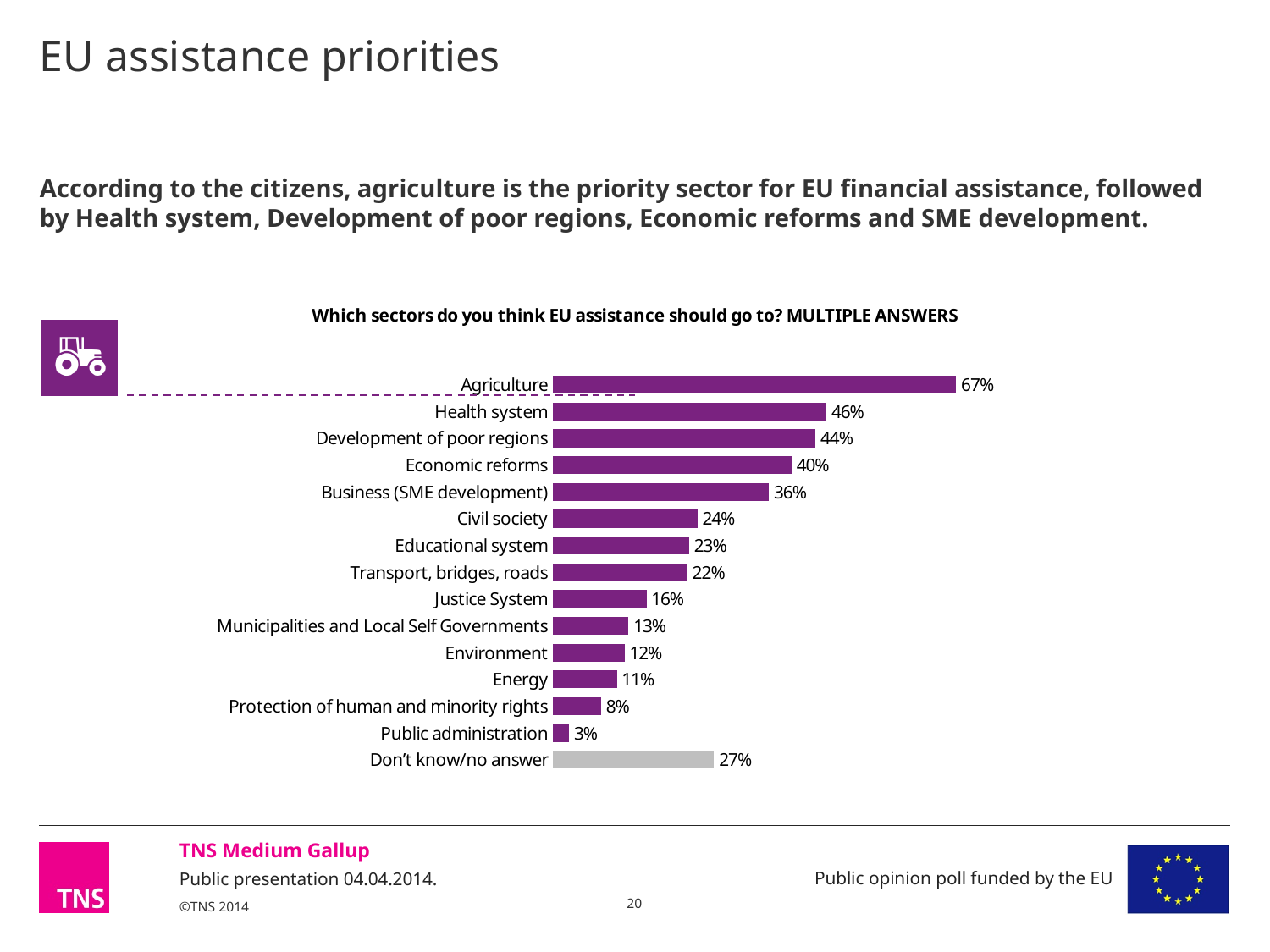
Which sector has the highest value in the chart? Agriculture Which has a larger value, Civil society or Educational system? Civil society How many categories (bars) are shown in the chart? 15 What is the difference between the values for Agriculture and Health system? 21 percentage points Which sector has the lowest value in the chart? Public administration What is the title of the chart? Which sectors do you think EU assistance should go to? MULTIPLE ANSWERS What is the value shown for Justice System? 16% What type of chart is shown on the slide? Bar chart What percentage of respondents said EU assistance should go to Agriculture? 67% What is the difference between the values for Economic reforms and Business (SME development)? 4 percentage points What is the value shown for Health system? 46% What is the value shown for Don't know/no answer? 27%